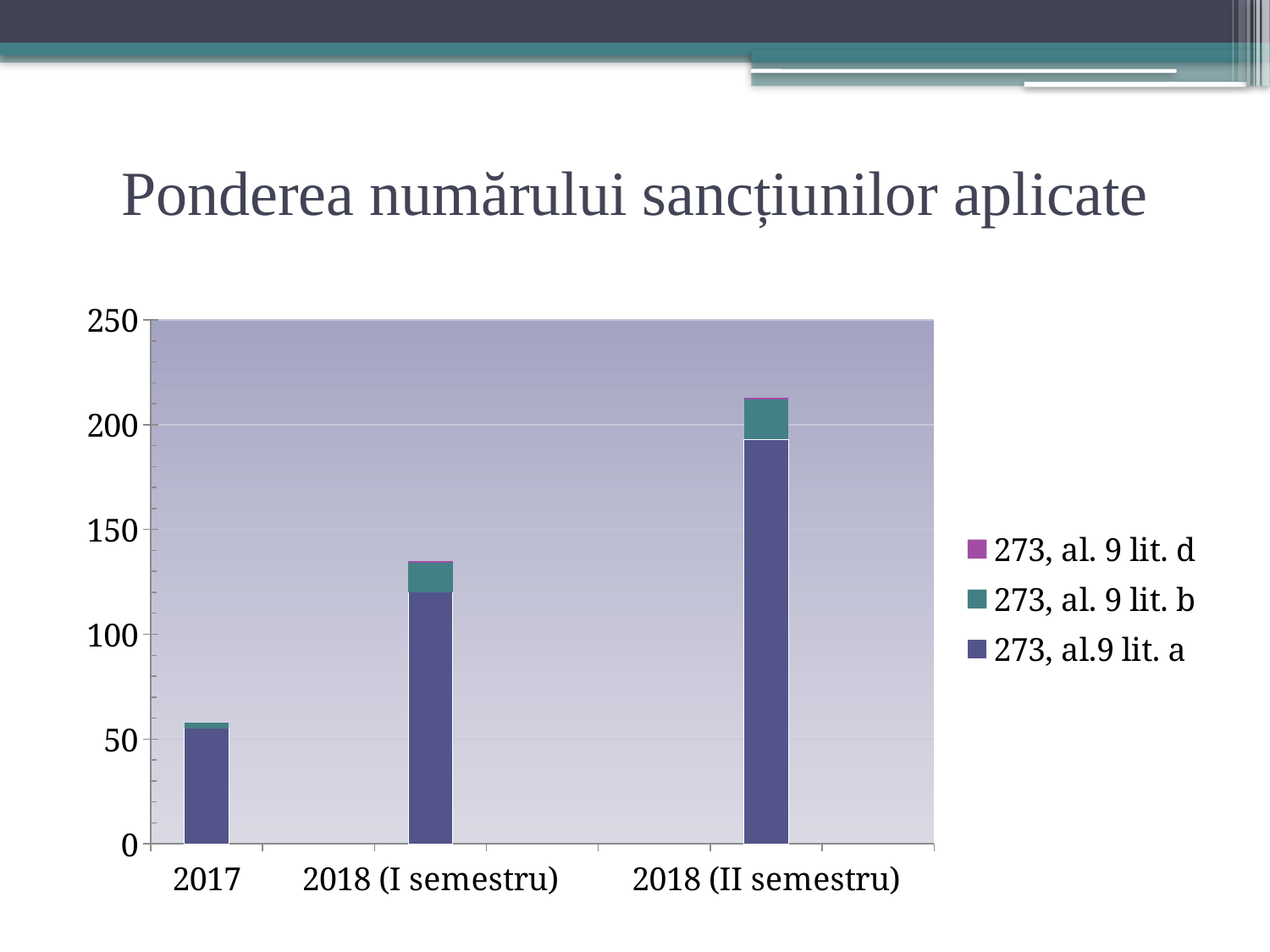
Which category has the tallest stacked bar? 2018 (II semestru) What kind of chart is shown on the slide? stacked bar chart Which is larger, the stacked bar for 2018 (I semestru) or the stacked bar for 2018 (II semestru)? 2018 (II semestru) Which category has the shortest stacked bar? 2017 What is the title of the chart on the slide? Ponderea numărului sancțiunilor aplicate Do the stacked bar totals rise or fall from 2017 to 2018 (II semestru)? rise How many categories are shown on the x axis? 3 How many series does the legend list? 3 Is the total of the stacked bar for 2018 (I semestru) greater or less than 100? greater Is the total of the stacked bar for 2017 greater or less than 100? less Is the total of the stacked bar for 2018 (II semestru) greater or less than 200? greater